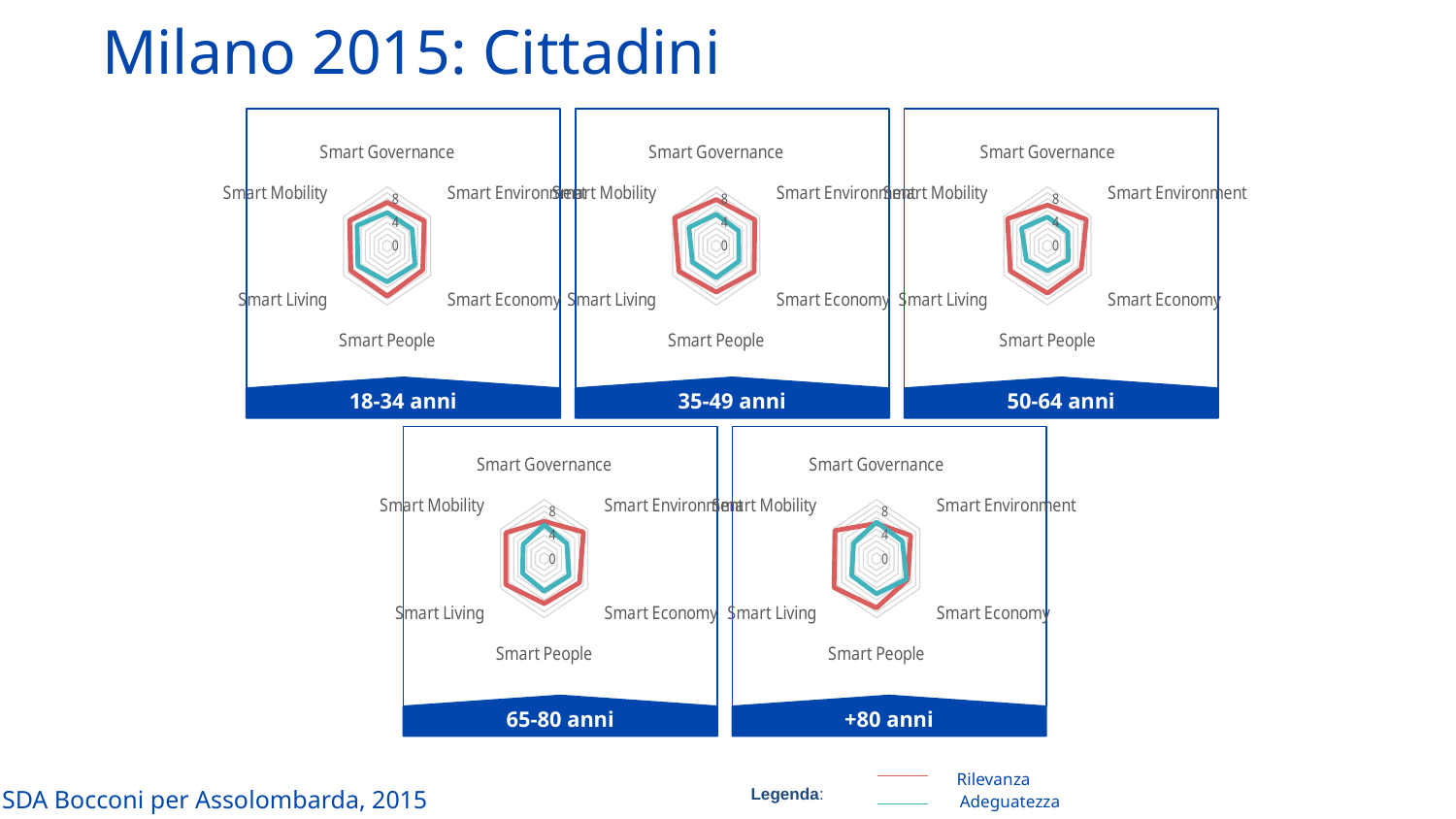
In the '18-34 anni' chart, is the Rilevanza value for Smart People greater or less than 4? greater What are the two series named in the legend? Rilevanza and Adeguatezza What is the title of the radar chart in the bottom-right panel? +80 anni In the '35-49 anni' chart, is the Rilevanza value for Smart Mobility greater or less than 4? greater In the '+80 anni' chart, which series is larger for Smart Living, Rilevanza or Adeguatezza? Rilevanza What is the maximum value shown on the radial axis of the '50-64 anni' chart? 8 How many axes (categories) does the '35-49 anni' radar chart have? 6 What kind of chart is used in the '18-34 anni' panel? Radar chart How many series does the legend list? 2 How many radar charts are shown on the slide? 5 In the '50-64 anni' chart, which series is larger for Smart Governance, Rilevanza or Adeguatezza? Rilevanza